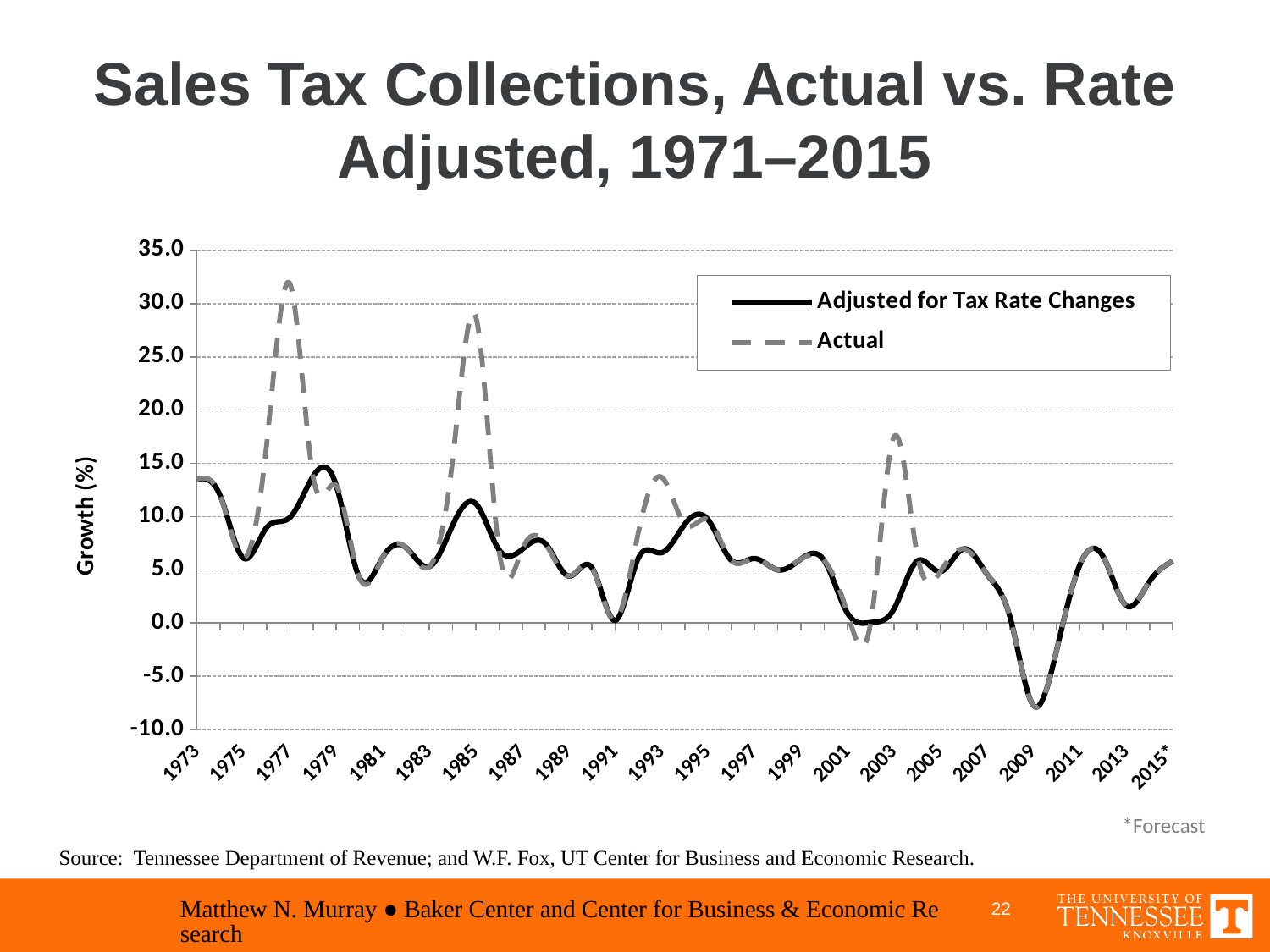
Around which year do both series reach their lowest value? 2009 What kind of chart is shown on the slide? line chart Is the Adjusted for Tax Rate Changes value in 2009 greater or less than -5.0? less Is the Actual series value in 1985 greater or less than 25.0? greater Is the Actual series value in 2003 greater or less than 15.0? greater Which series reaches the highest peak on the chart? Actual What is the label on the vertical axis? Growth (%) What are the two series named in the legend? Adjusted for Tax Rate Changes; Actual In 1977, which series has the higher value, Actual or Adjusted for Tax Rate Changes? Actual In which year does the Actual series reach its highest value? 1977 How many series does the legend list? 2